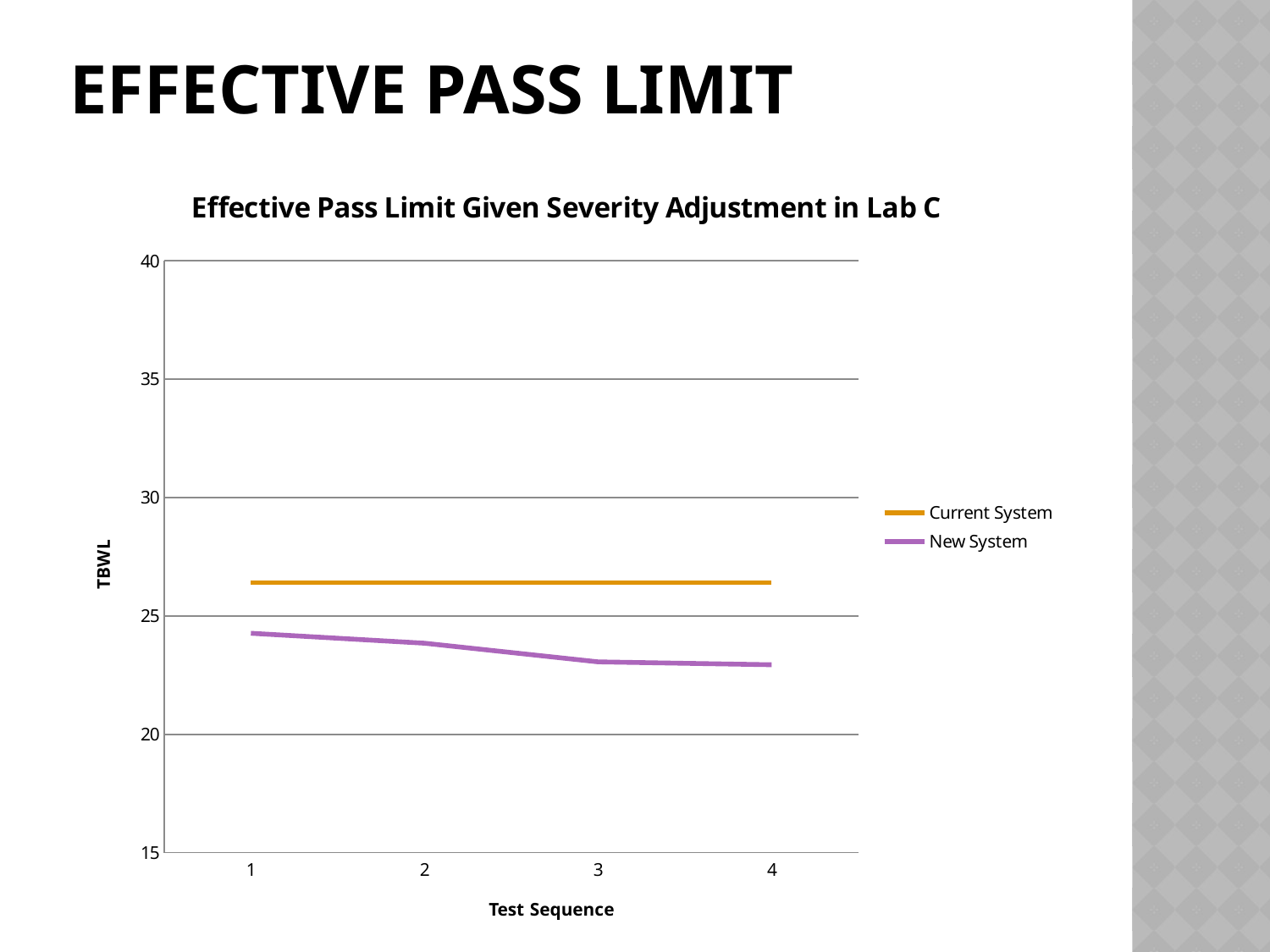
How many test sequence points are plotted on the x axis? 4 Which series has the higher value at test sequence 3, Current System or New System? Current System What is the title of the chart? Effective Pass Limit Given Severity Adjustment in Lab C Is the value for New System at test sequence 1 greater or less than 20? greater How many series does the legend list? 2 Is the value for New System at test sequence 4 greater or less than 25? less What type of chart is shown on the slide? line chart Does the New System line rise or fall from test sequence 1 to test sequence 4? fall Is the value for Current System at test sequence 2 greater or less than 25? greater At which test sequence does the New System line reach its lowest value? 4 What is the label of the y axis? TBWL